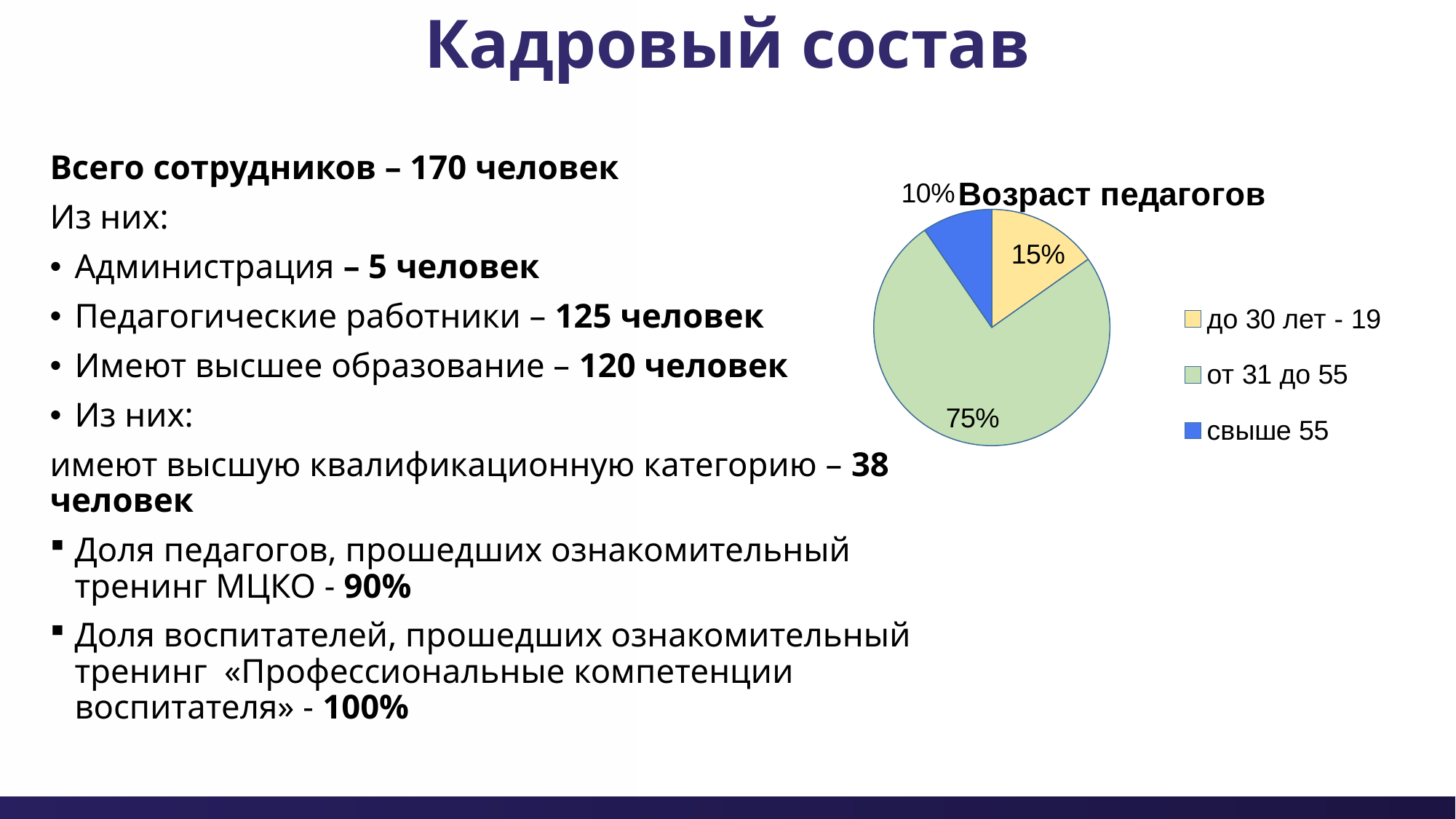
Which age group has the largest slice in the pie chart? от 31 до 55 What type of chart is shown on the slide? pie chart Which age group has the smallest slice in the pie chart? свыше 55 What is the difference in percentage points between the 'до 30 лет - 19' slice and the 'свыше 55' slice? 5 What share of the pie does the 'до 30 лет - 19' slice represent? 15% How many slices does the pie chart have? 3 What colour is the 'свыше 55' slice in the pie chart? blue What share of the pie does the 'от 31 до 55' slice represent? 75% What is the difference in percentage points between the 'от 31 до 55' slice and the 'до 30 лет - 19' slice? 60 What is the title of the chart? Возраст педагогов What share of the pie does the 'свыше 55' slice represent? 10% Which slice is larger: 'до 30 лет - 19' or 'свыше 55'? до 30 лет - 19